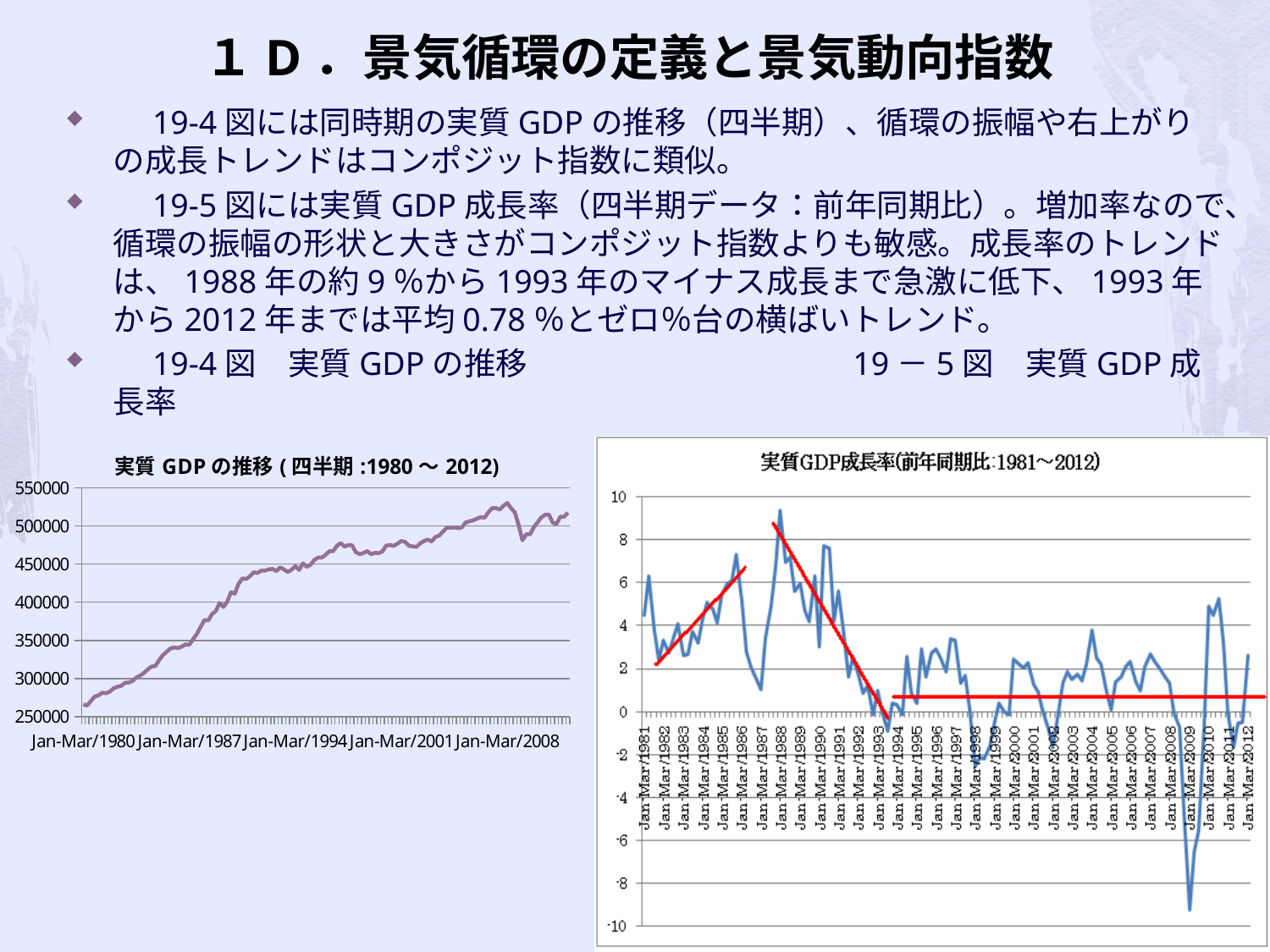
What is the title of the left chart? 実質GDPの推移(四半期:1980～2012) What kind of chart is the right chart titled 実質GDP成長率(前年同期比:1981～2012)? line chart In the left chart 実質GDPの推移, do the values generally rise or fall from 1980 to 2012? rise In the left chart 実質GDPの推移, is the value at Jan-Mar/1980 greater or less than 300000? less In the right chart 実質GDP成長率, what is the maximum value shown on the vertical axis? 10 What kind of chart is the left chart titled 実質GDPの推移(四半期:1980～2012)? line chart In the left chart 実質GDPの推移, is the value at Jan-Mar/2001 greater or less than 450000? greater In the left chart 実質GDPの推移, is the value at Jan-Mar/2008 greater or less than 500000? greater In the right chart 実質GDP成長率, in which year does the line reach its lowest point? 2009 In the left chart 実質GDPの推移, which is larger, the value at Jan-Mar/1980 or the value at Jan-Mar/2008? Jan-Mar/2008